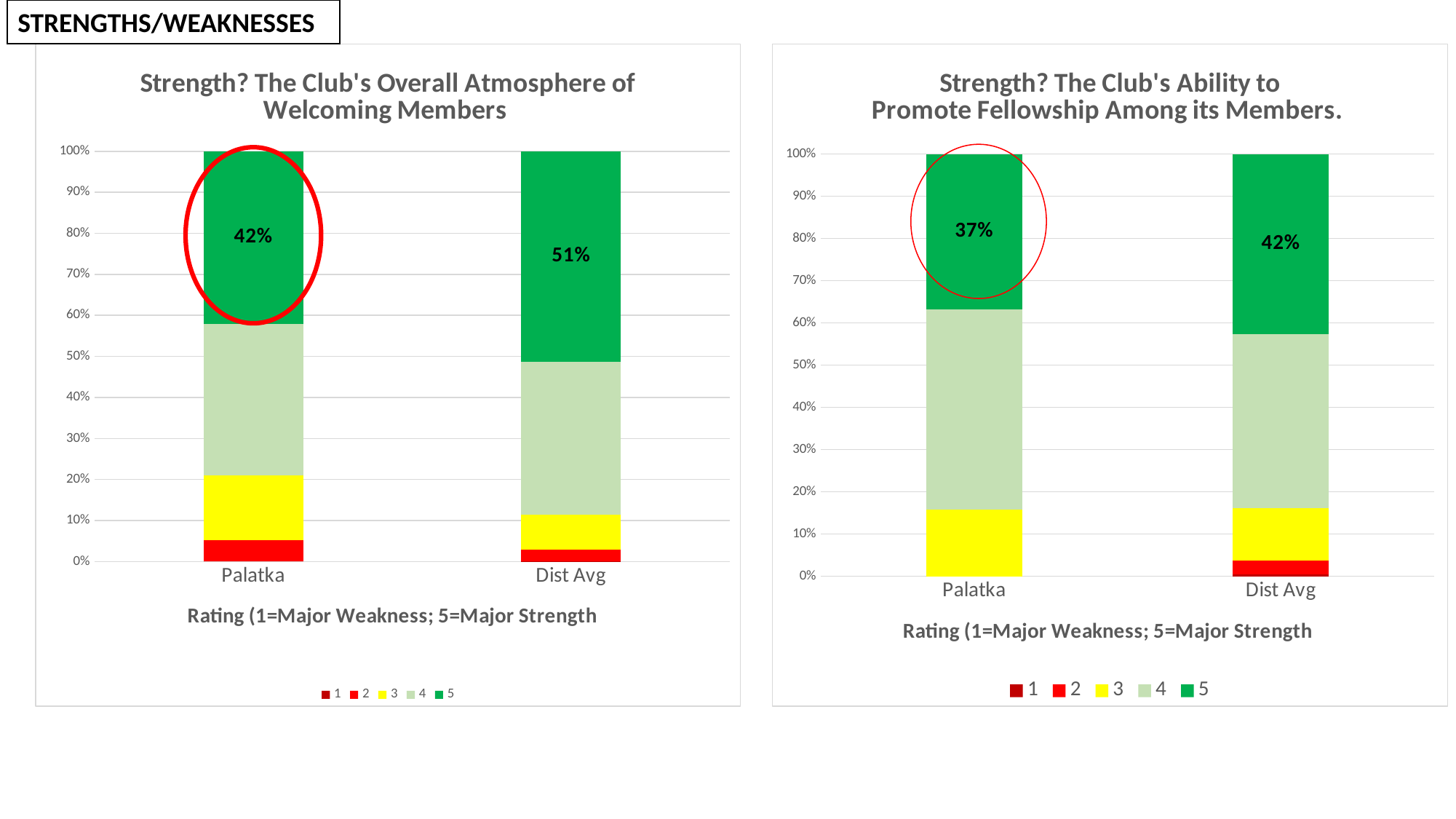
In the right chart (Ability to Promote Fellowship), is the rating-3 share for Palatka greater or less than 10%? greater What kind of chart is the left chart (Overall Atmosphere of Welcoming Members)? Stacked bar chart In the left chart (Overall Atmosphere of Welcoming Members), is the rating-4 share for Palatka greater or less than 30%? greater How many series does the legend of the right chart (Ability to Promote Fellowship) list? 5 In the right chart (Ability to Promote Fellowship), what percentage is labelled on the rating-5 segment for Palatka? 37% In the left chart (Overall Atmosphere of Welcoming Members), how many percentage points higher is the Dist Avg rating-5 share than the Palatka rating-5 share? 9 percentage points In the left chart (Overall Atmosphere of Welcoming Members), what percentage is labelled on the rating-5 segment for Palatka? 42% In the right chart (Ability to Promote Fellowship), what percentage is labelled on the rating-5 segment for Dist Avg? 42% In the left chart (Overall Atmosphere of Welcoming Members), what percentage is labelled on the rating-5 segment for Dist Avg? 51% In the right chart (Ability to Promote Fellowship), which has the larger rating-5 share, Palatka or Dist Avg? Dist Avg In the left chart (Overall Atmosphere of Welcoming Members), which has the larger rating-5 share, Palatka or Dist Avg? Dist Avg In the right chart (Ability to Promote Fellowship), what is the difference between the Dist Avg and Palatka rating-5 shares? 5 percentage points